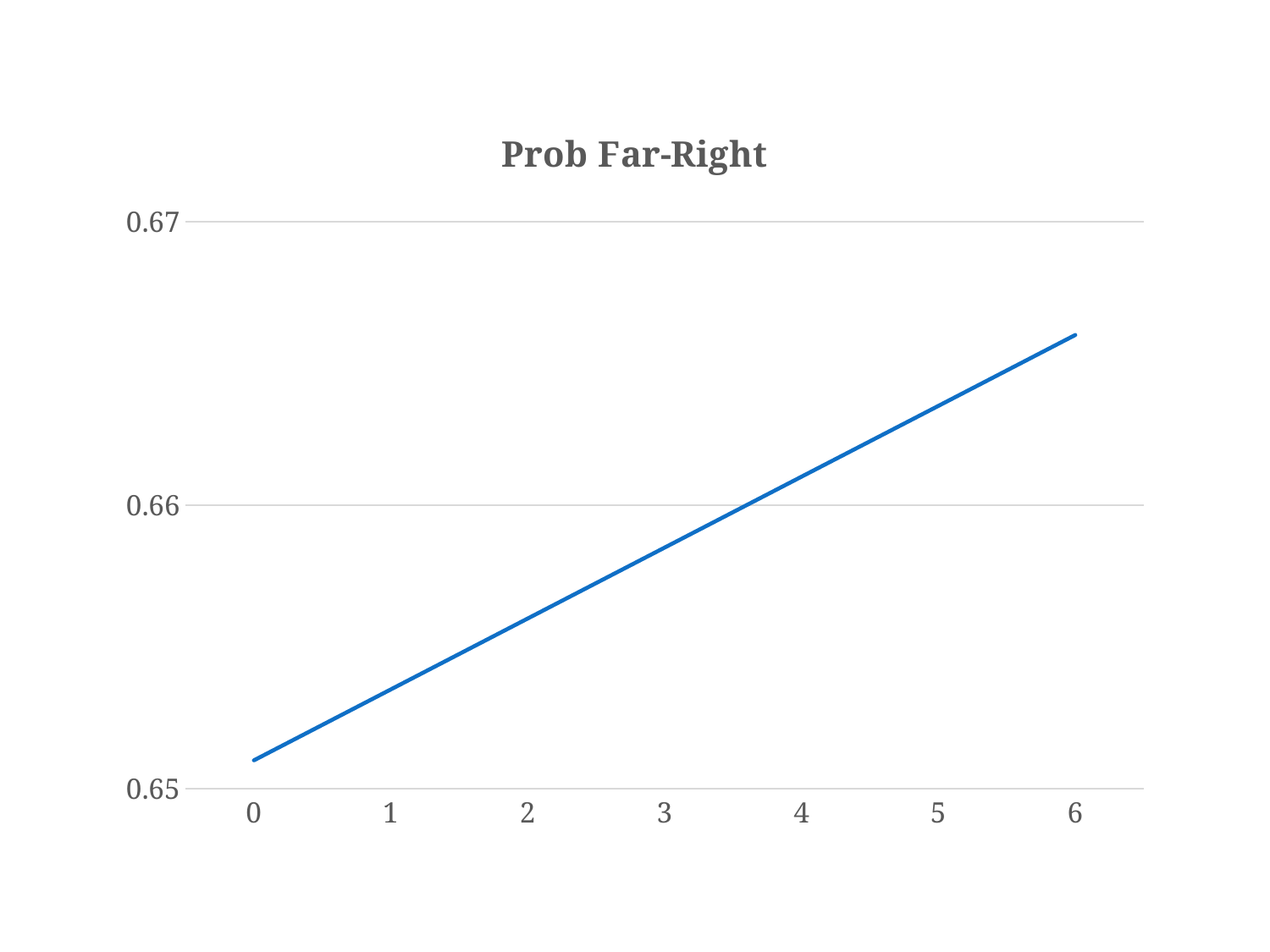
Is the value at x = 0 greater or less than 0.66? less Is the value at x = 1 greater or less than 0.66? less What is the title of the chart? Prob Far-Right Which is larger, the value at x = 0 or the value at x = 6? x = 6 How many tick labels are shown on the x axis? 7 At which x value does the line reach its highest point? 6 What kind of chart is shown on the slide? line chart Is the value at x = 5 greater or less than 0.66? greater Does the line rise or fall as the x axis goes from 0 to 6? rise At which x value does the line reach its lowest point? 0